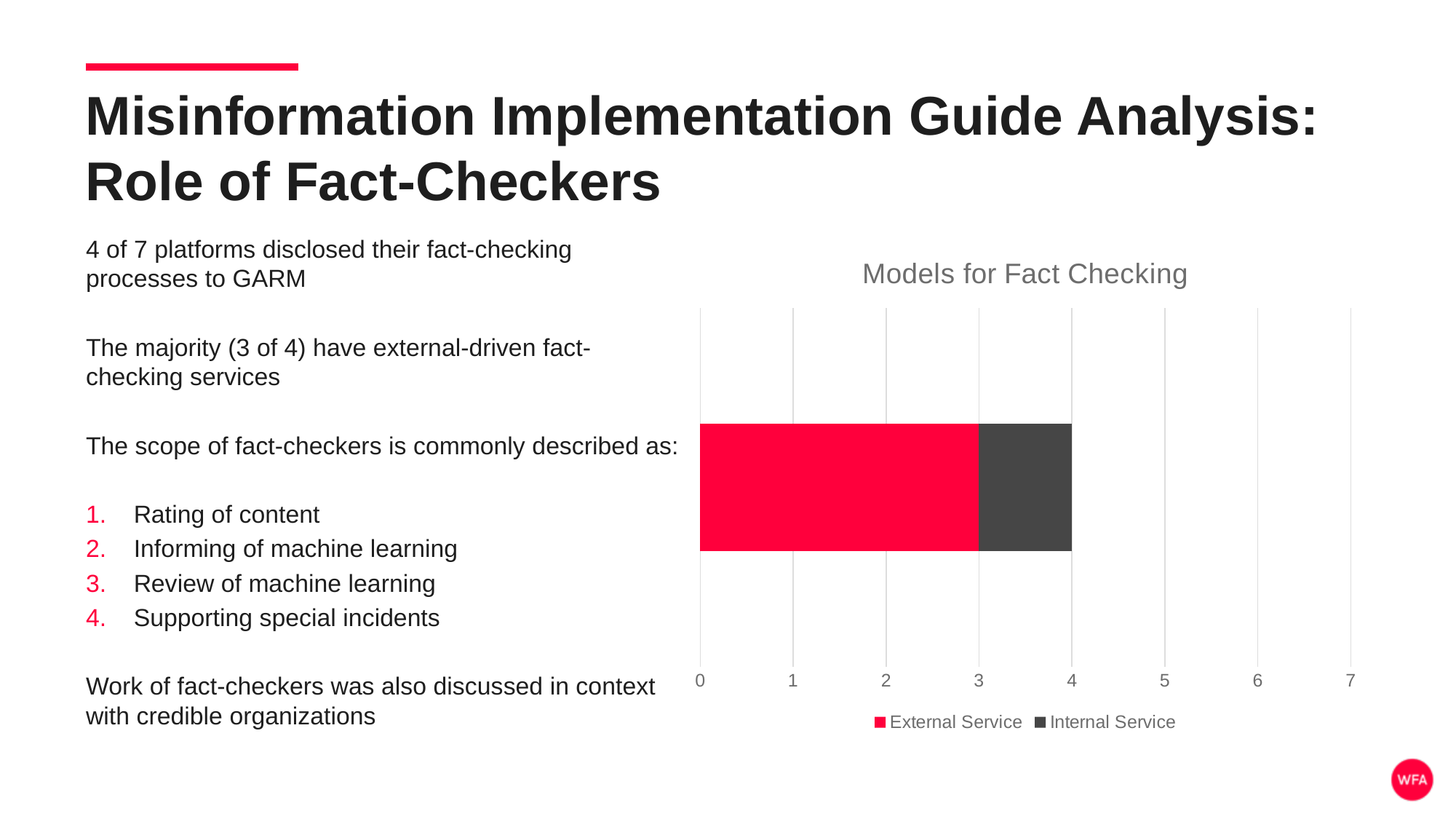
What is the total of the stacked bar in the chart? 4 Is the total of the stacked bar greater or less than 5? less How many bars are plotted in the chart? 1 How many series does the chart legend list? 2 What is the value for Internal Service in the chart? 1 What is the value for External Service in the chart? 3 What are the two series named in the chart legend? External Service and Internal Service Which series has the larger value, External Service or Internal Service? External Service What is the highest value shown on the chart's x axis? 7 What kind of chart is shown on the slide? Stacked bar chart What is the title of the chart? Models for Fact Checking What is the difference between the External Service and Internal Service values? 2